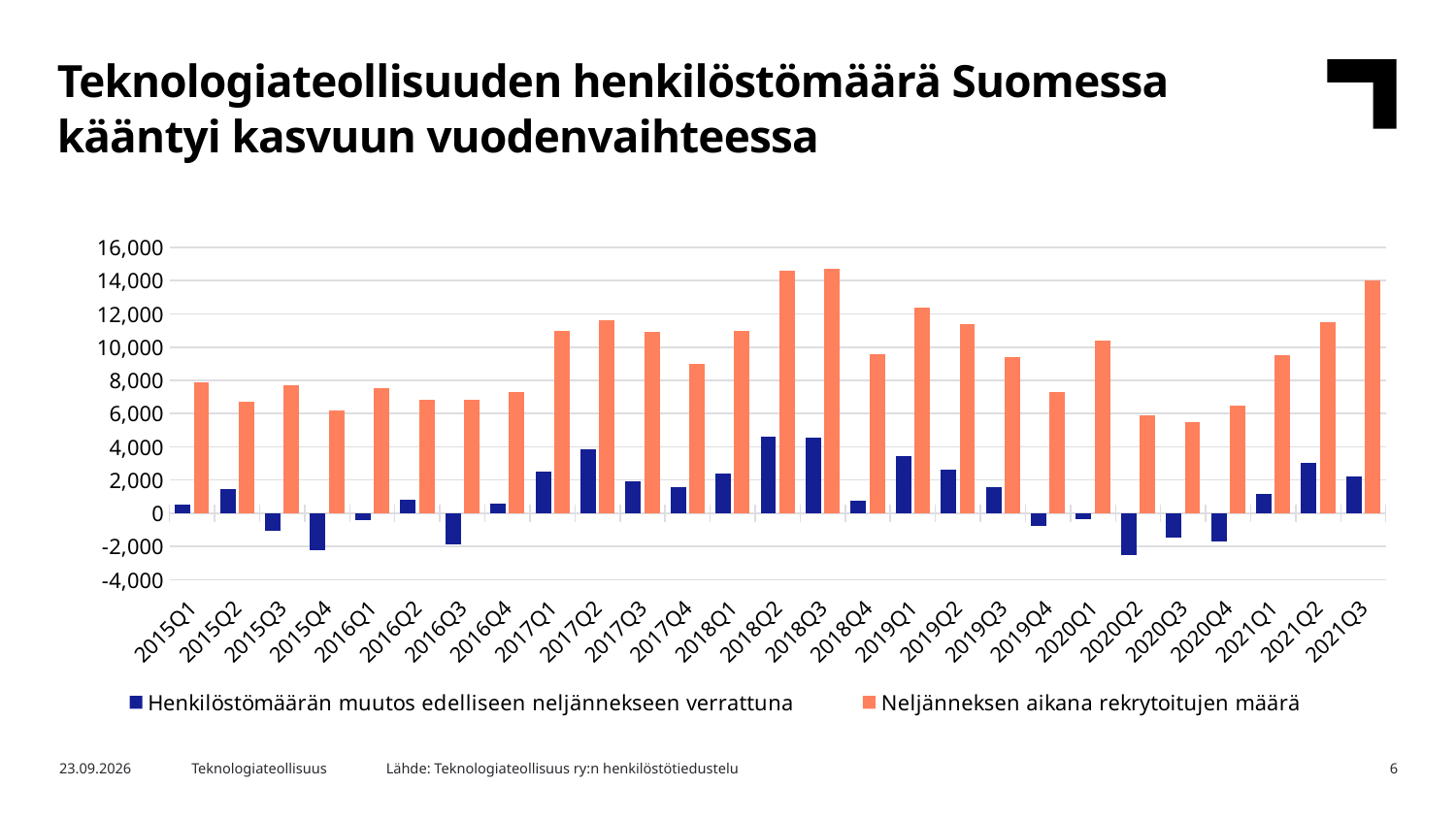
Is the value of 'Henkilöstömäärän muutos edelliseen neljännekseen verrattuna' for 2020Q2 greater or less than -2,000? less Which quarter has the lowest value for 'Henkilöstömäärän muutos edelliseen neljännekseen verrattuna'? 2020Q2 How many series does the legend list? 2 Is the value of 'Henkilöstömäärän muutos edelliseen neljännekseen verrattuna' for 2017Q2 greater or less than 2,000? greater Is the value of 'Neljänneksen aikana rekrytoitujen määrä' for 2019Q1 greater or less than 10,000? greater What kind of chart is shown on the slide? bar chart Which is larger for 'Neljänneksen aikana rekrytoitujen määrä': 2018Q2 or 2016Q1? 2018Q2 How many quarters are shown on the x axis? 27 What colour represents 'Neljänneksen aikana rekrytoitujen määrä' in the chart? orange Do the values of 'Neljänneksen aikana rekrytoitujen määrä' rise or fall from 2020Q3 to 2021Q3? rise